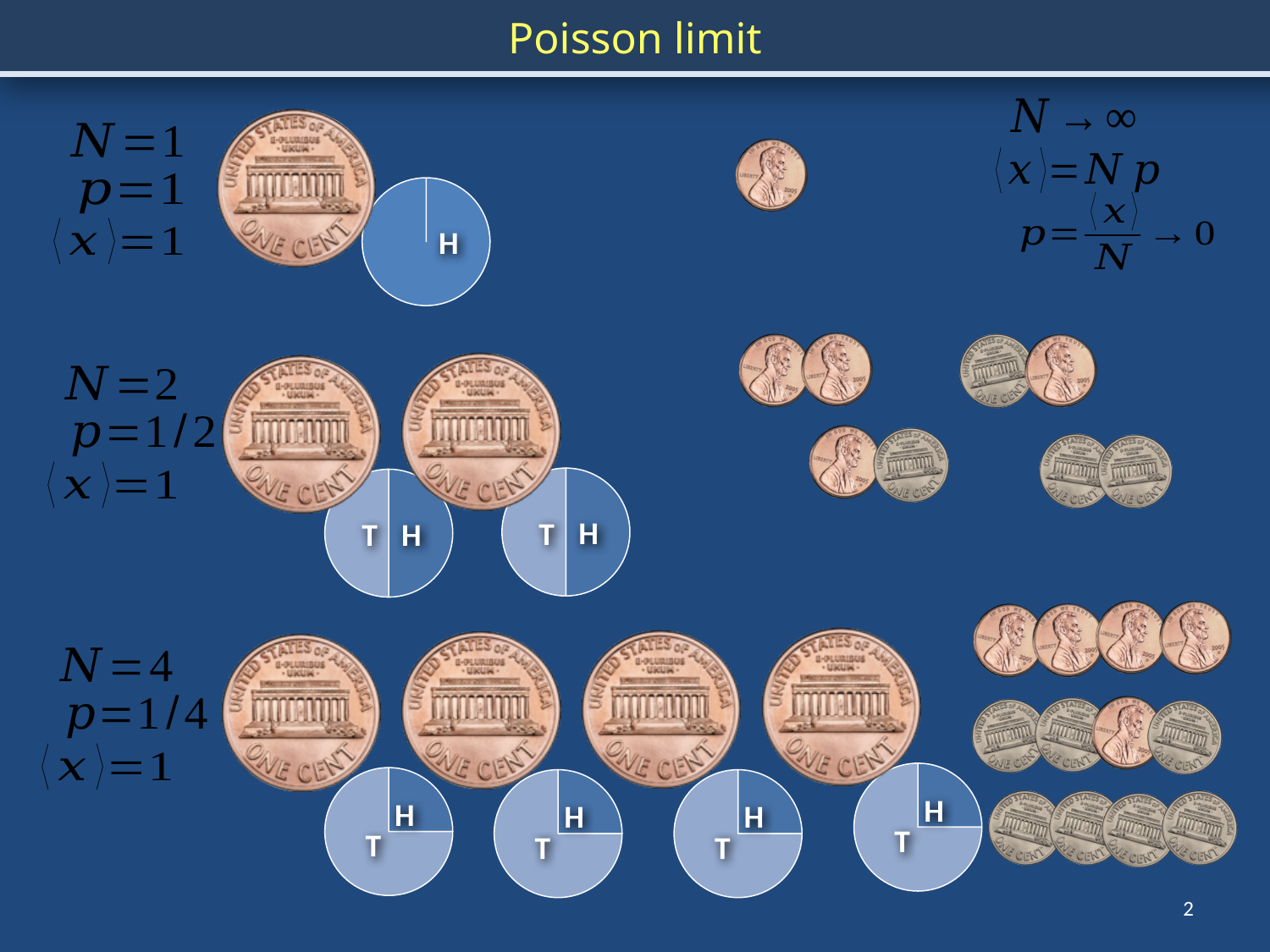
What kind of chart is used in the N=1 row of the slide? pie chart In the N=1 row, what is the label of the only slice in the pie chart? H In the N=2 row, how many slices does each pie chart have? 2 In the N=4 row, which slice of each pie chart is larger, H or T? T In the N=4 row, what share of each pie chart does the H slice take, given the printed p value? 1/4 In the N=2 row, what share of each pie chart does the H slice take, given the printed p value? 1/2 What is the title of the slide containing the pie charts? Poisson limit In the N=4 row, how many pie charts are shown? 4 In the N=4 row, what are the two slice labels used in each pie chart? H and T In the N=2 row, how many pie charts are shown? 2